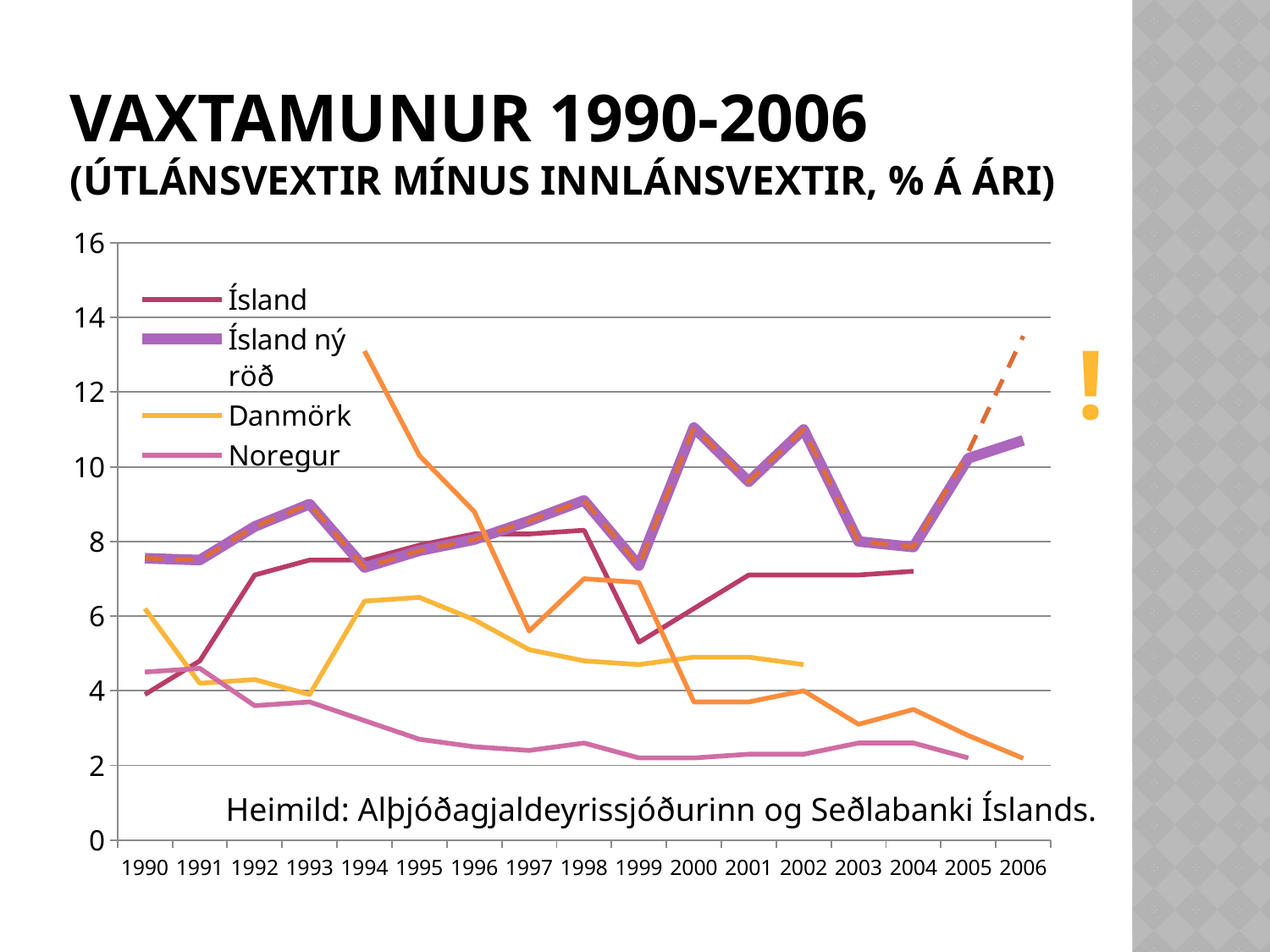
Is the value for Ísland ný röð in 1999 greater or less than 8? less What is the main title of the chart on the slide? Vaxtamunur 1990-2006 What kind of chart is shown on the slide? line chart How many series does the legend list? 4 In 2000, which is higher: Ísland or Ísland ný röð? Ísland ný röð Which series has the lowest value in 2005? Noregur Is the value for Danmörk in 1995 greater or less than 6? greater How many years are shown along the x axis? 17 Is the value for Ísland ný röð in 2000 greater or less than 10? greater Does the Noregur line generally rise or fall from 1990 to 2005? fall